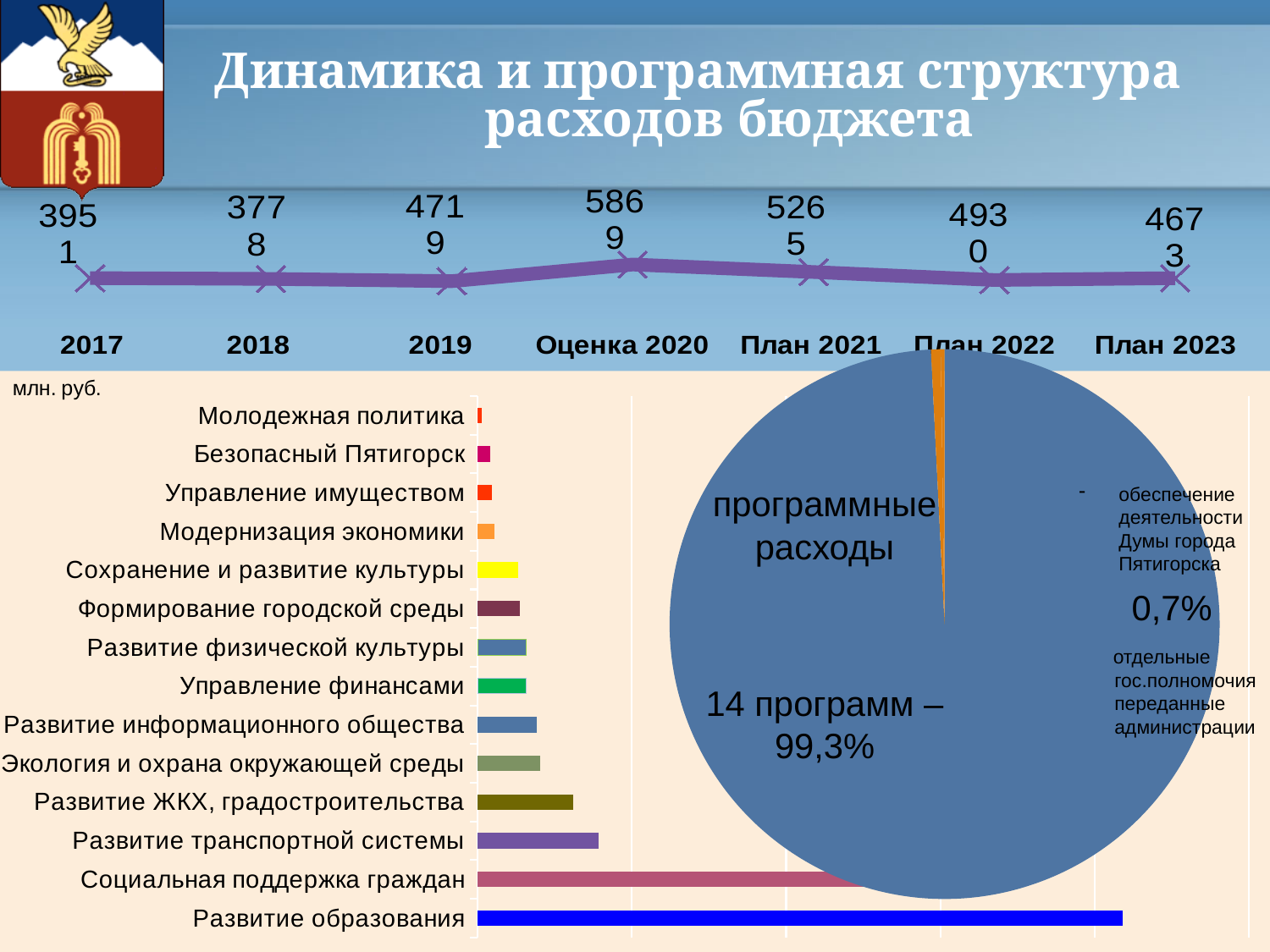
On the line chart at the top, what is the value for Оценка 2020? 5869 On the horizontal bar chart at the bottom left, which bar is longer, Развитие транспортной системы or Развитие ЖКХ, градостроительства? Развитие транспортной системы On the line chart at the top, which year has the highest value? Оценка 2020 On the horizontal bar chart at the bottom left, which category has the longest bar? Развитие образования On the line chart at the top, what is the value for 2017? 3951 On the line chart at the top, how many data points are plotted? 7 On the pie chart, what share is labelled for программные расходы (14 программ)? 99,3% On the horizontal bar chart at the bottom left, how many categories are shown? 14 On the line chart at the top, what is the value for План 2023? 4673 On the line chart at the top, which is larger, the value for 2019 or the value for План 2022? План 2022 On the line chart at the top, what is the difference between the values for Оценка 2020 and План 2021? 604 On the line chart at the top, which year has the lowest value? 2018